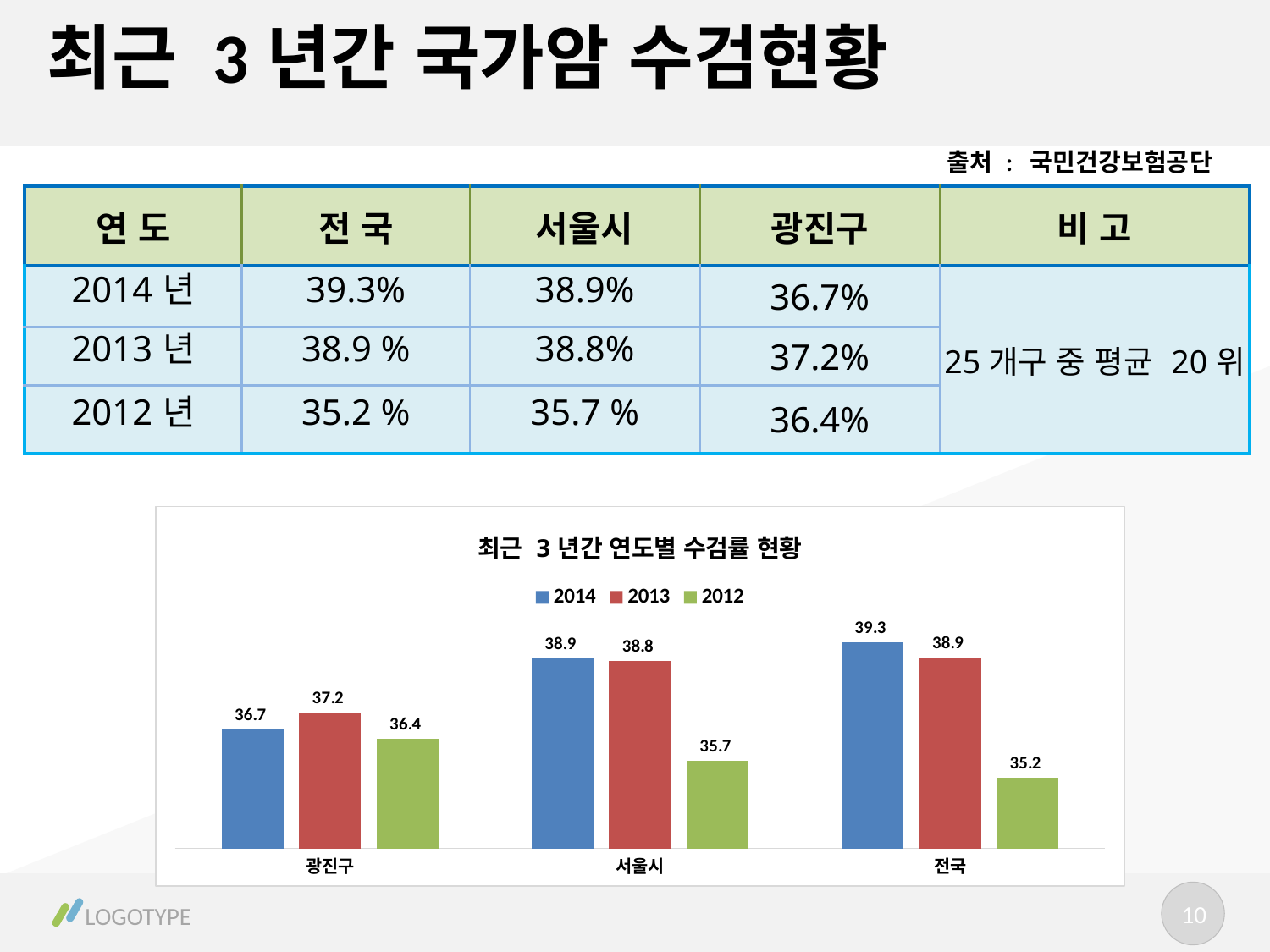
What is the value for 서울시 in the 2012 series? 35.7 What is the difference between the 2013 and 2012 values for 광진구? 0.8 For 광진구, which series has the larger value, 2013 or 2012? 2013 What is the title of the chart? 최근 3년간 연도별 수검률 현황 How many series does the chart legend list? 3 Which category has the lowest value in the 2012 series? 전국 How many categories are shown on the x axis of the chart? 3 What is the value for 광진구 in the 2014 series? 36.7 What kind of chart is shown on the slide? bar chart What is the difference between the 2014 and 2012 values for 전국? 4.1 What is the value for 전국 in the 2013 series? 38.9 Which category has the highest value in the 2014 series? 전국